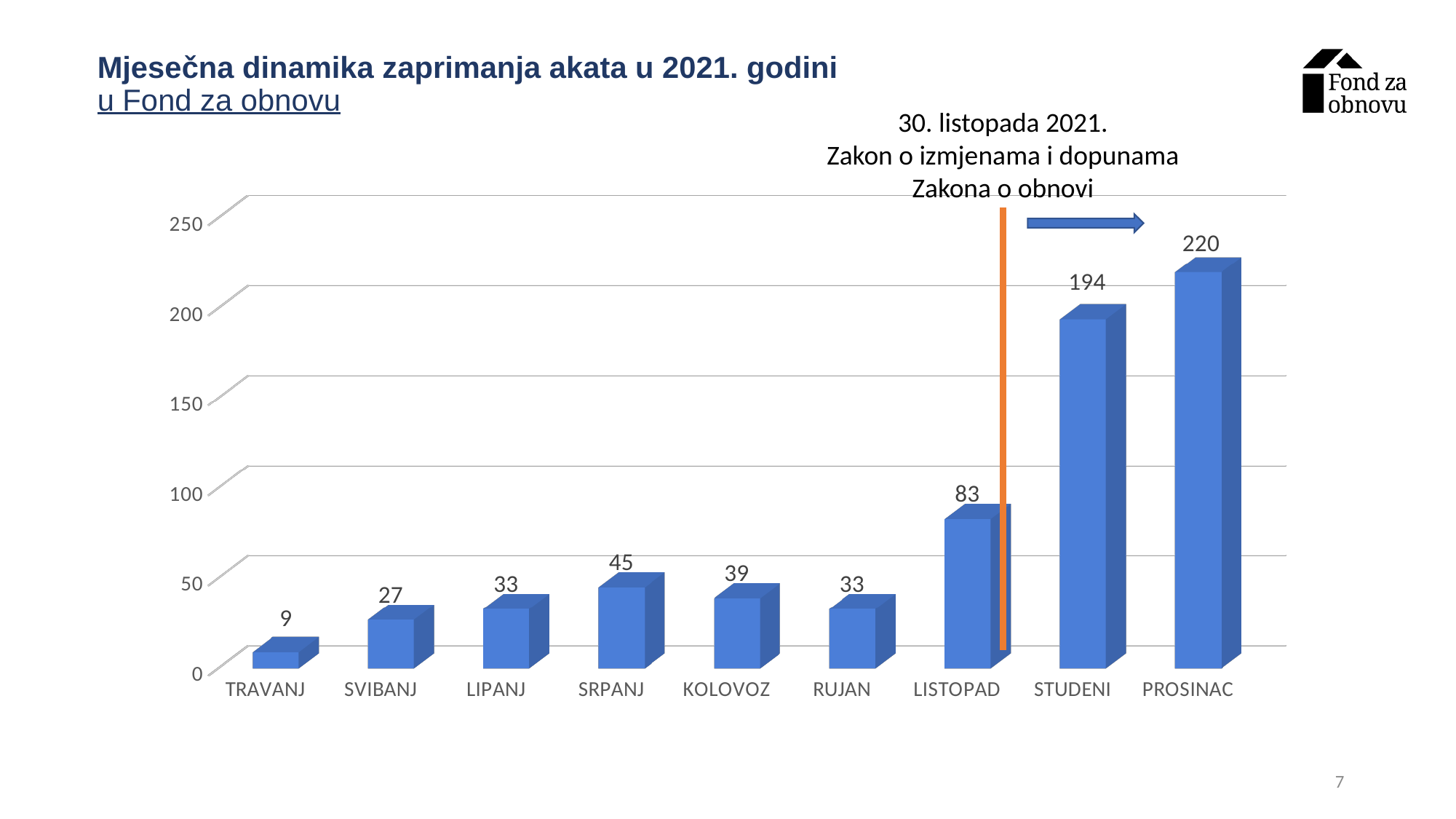
Is the value for STUDENI greater or less than 150? greater What is the value for SRPANJ? 45 How many months are shown on the x axis? 9 Which month has the lowest value? TRAVANJ What is the difference between the values for PROSINAC and STUDENI? 26 What is the difference between the values for LISTOPAD and RUJAN? 50 What is the value for LISTOPAD? 83 What is the title of the chart on the slide? Mjesečna dinamika zaprimanja akata u 2021. godini u Fond za obnovu What is the value for TRAVANJ? 9 Which is larger, the value for KOLOVOZ or the value for SVIBANJ? KOLOVOZ Which month has the highest value? PROSINAC What kind of chart is shown on the slide? bar chart